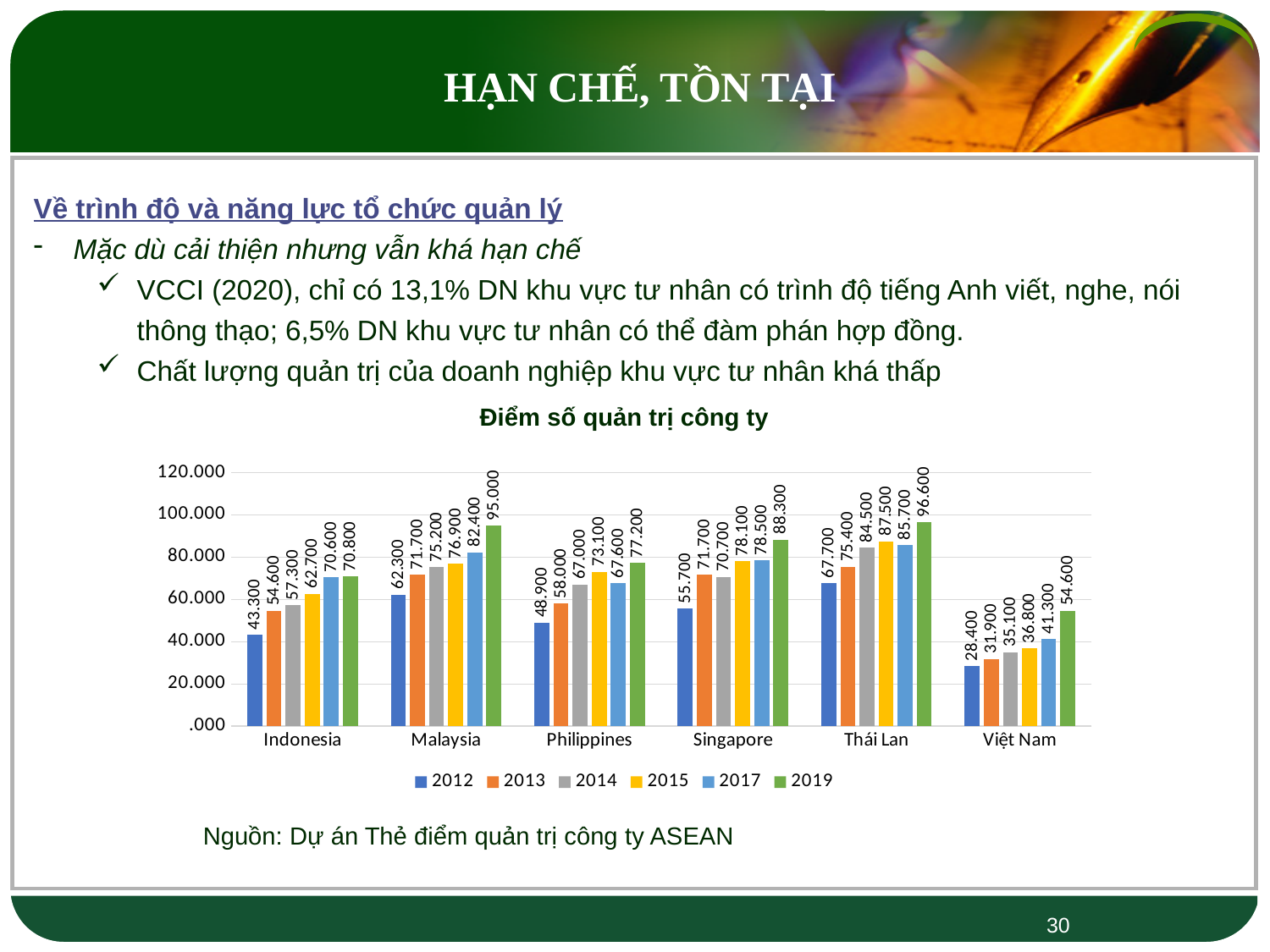
What is the title of the chart? Điểm số quản trị công ty Which country has the lowest value in 2012? Việt Nam What is the value for Việt Nam in 2019? 54.600 What is the difference between Thái Lan and Việt Nam in 2019? 42.000 How many series does the legend list? 6 What is the value for Indonesia in 2012? 43.300 What is the value for Thái Lan in 2015? 87.500 What kind of chart is shown? bar chart Is the value for Philippines in 2019 greater or less than 80.000? less How many countries are shown on the x axis? 6 Which country has the highest value in 2019? Thái Lan Which is larger: Malaysia in 2017 or Singapore in 2017? Malaysia in 2017